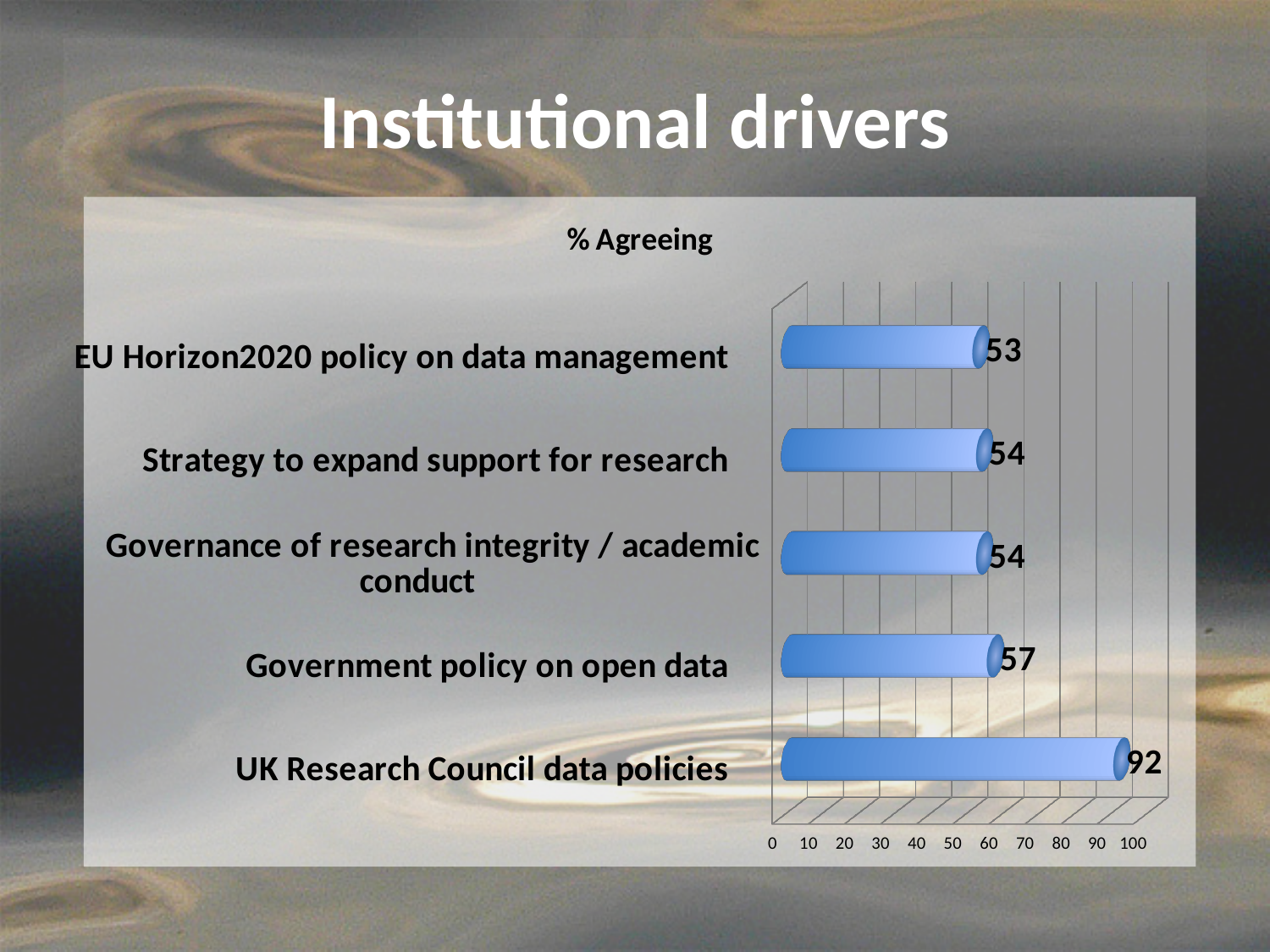
What is the value for EU Horizon2020 policy on data management? 53 Is the value for Governance of research integrity / academic conduct greater or less than 50? greater What is the title of the chart? % Agreeing Which category has the lowest value? EU Horizon2020 policy on data management What is the value for Government policy on open data? 57 What kind of chart is shown on the slide? bar chart How many categories are shown in the chart? 5 What is the value for UK Research Council data policies? 92 Which is larger: the value for Government policy on open data or the value for Strategy to expand support for research? Government policy on open data What is the value for Strategy to expand support for research? 54 Which category has the highest value? UK Research Council data policies What is the difference between the values for UK Research Council data policies and Government policy on open data? 35